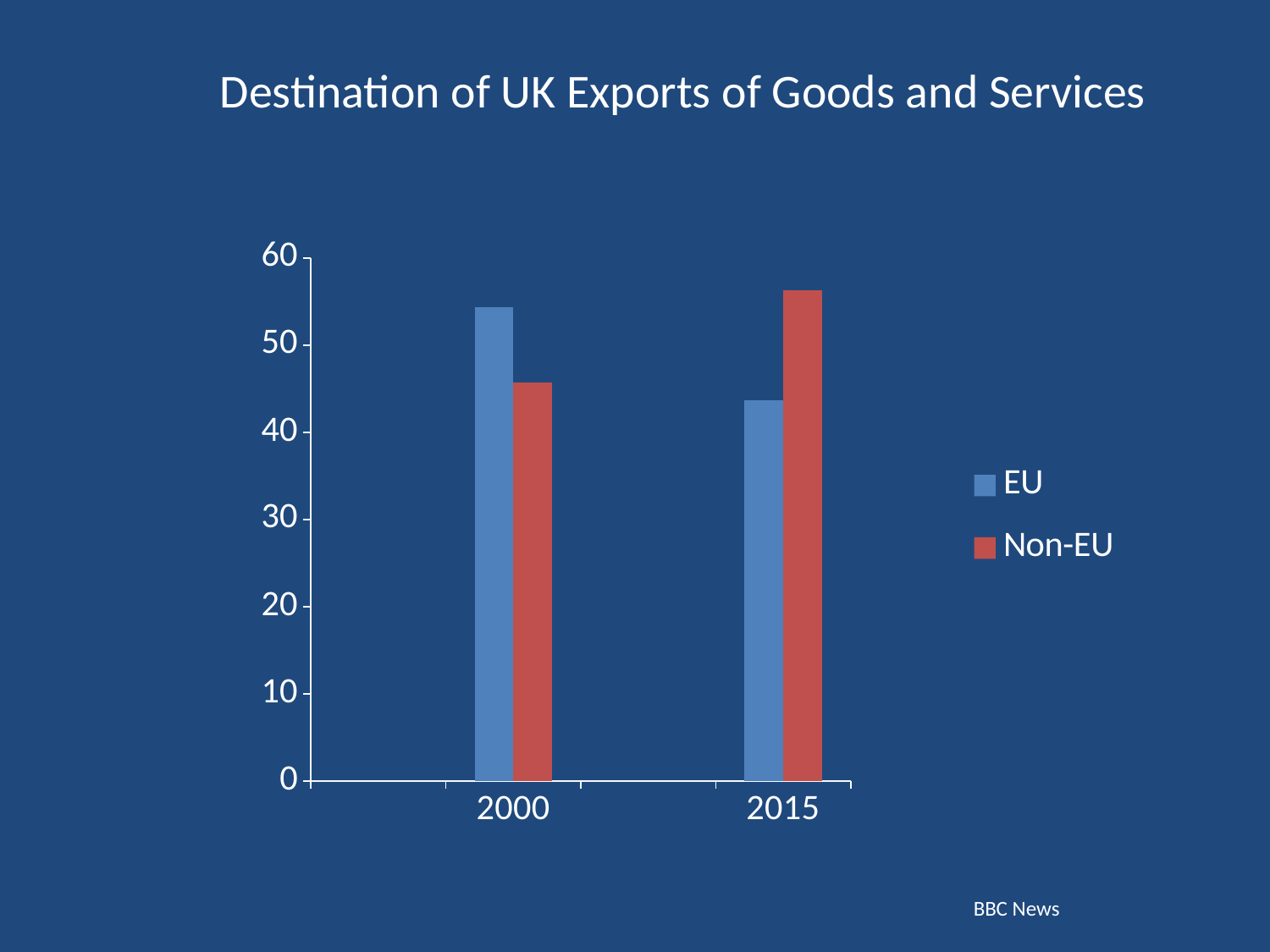
Does the EU series rise or fall from 2000 to 2015? fall Is the value for EU in 2000 greater or less than 50? greater What is the title of the chart? Destination of UK Exports of Goods and Services What kind of chart is shown on the slide? bar chart Is the value for EU in 2015 greater or less than 50? less Is the value for Non-EU in 2000 greater or less than 50? less How many series does the legend list? 2 Does the Non-EU series rise or fall from 2000 to 2015? rise In 2000, which is larger, EU or Non-EU? EU In 2015, which is larger, EU or Non-EU? Non-EU How many years are shown on the x axis? 2